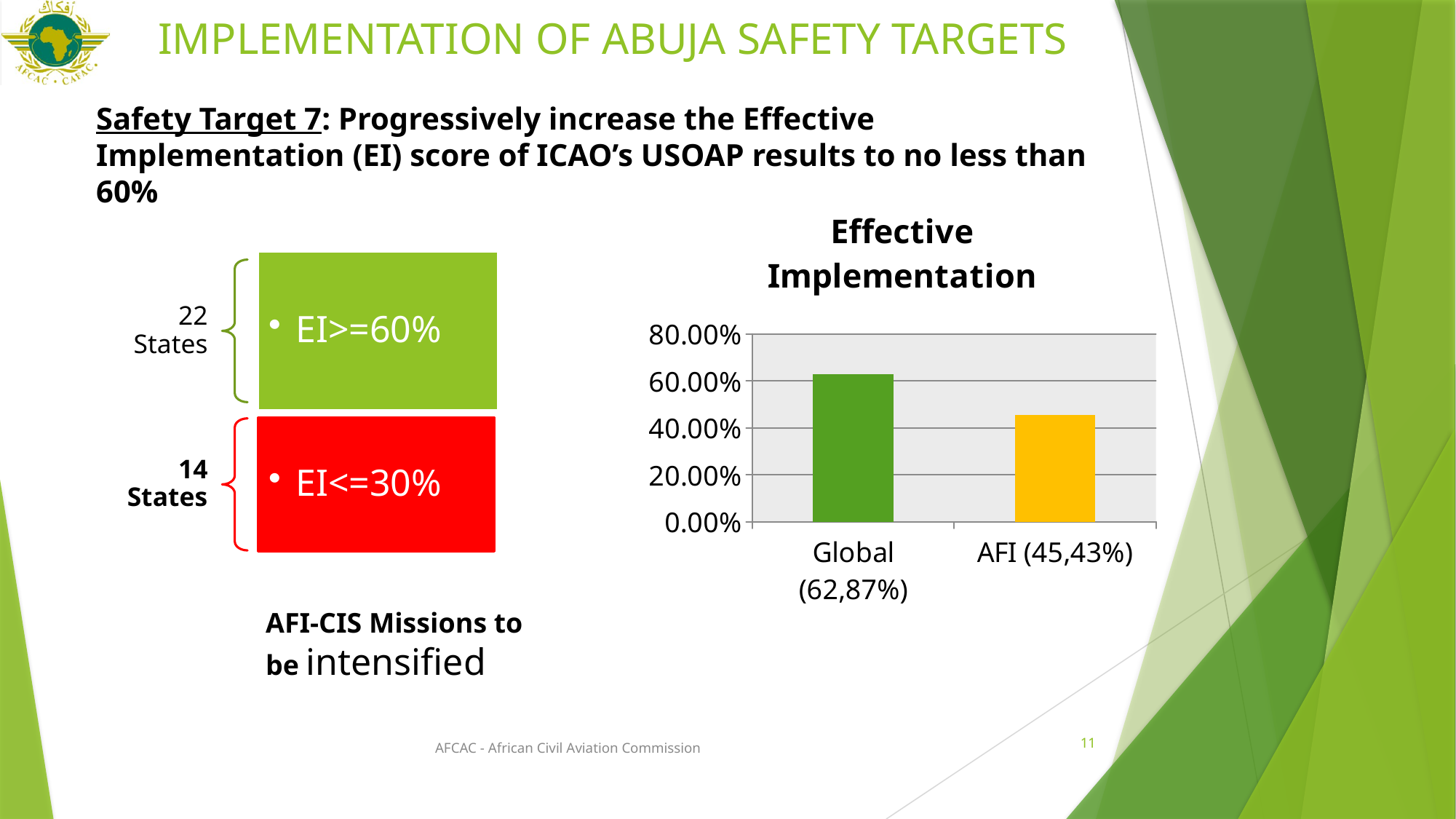
Is the value for AFI greater or less than 60.00%? less What is the title of the chart on the slide? Effective Implementation What is the Effective Implementation value for Global? 62,87% How many categories are plotted in the Effective Implementation chart? 2 Which category has the lowest value in the Effective Implementation chart? AFI What type of chart is shown under the title "Effective Implementation"? bar chart What is the Effective Implementation value for AFI? 45,43% What is the difference between the Global and AFI Effective Implementation values? 17,44% Which category has the highest value in the Effective Implementation chart? Global Is the value for Global greater or less than 60.00%? greater Which category has the higher Effective Implementation value, Global or AFI? Global What is the highest value shown on the y axis of the Effective Implementation chart? 80.00%